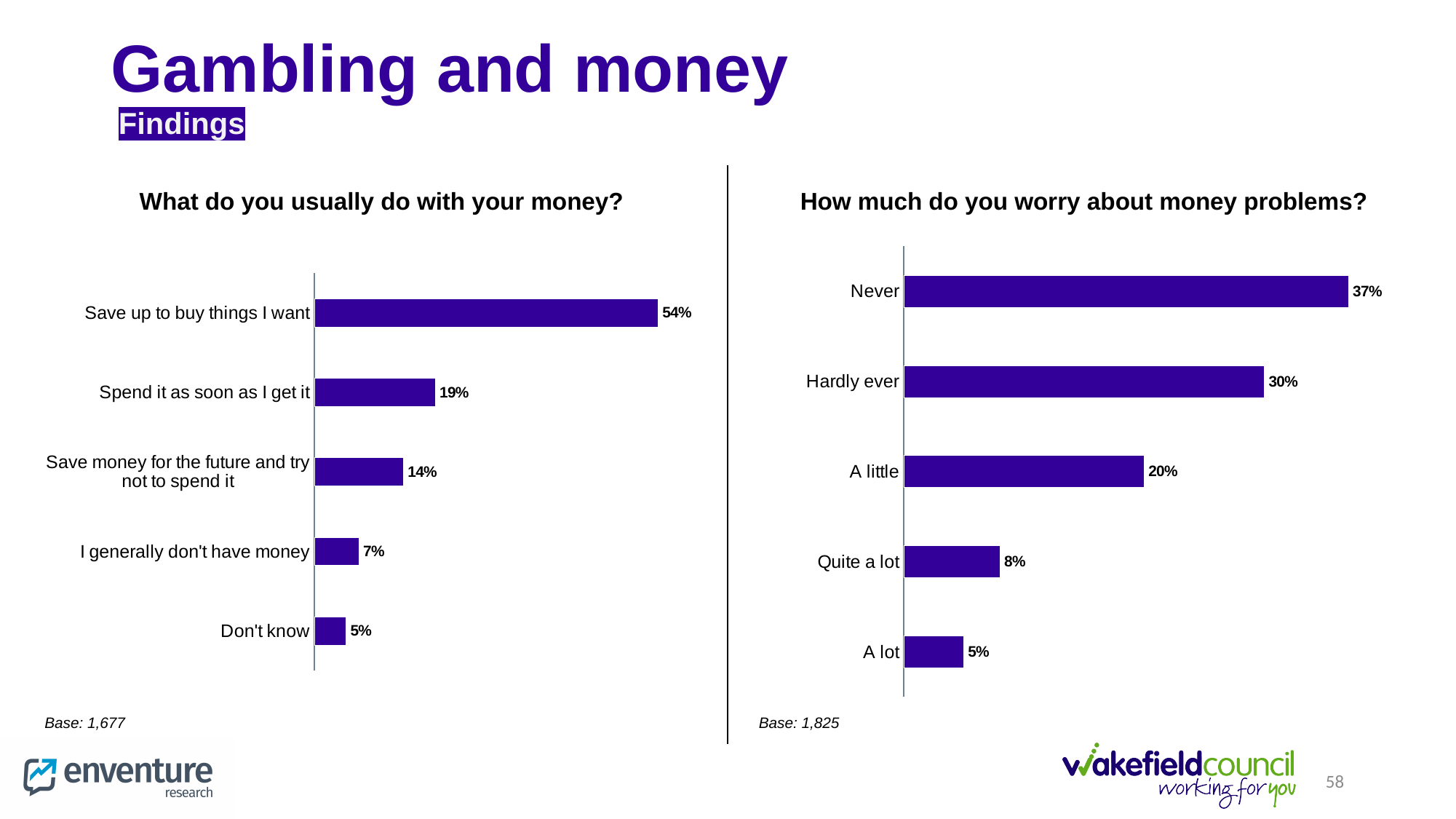
In the chart 'How much do you worry about money problems?', which is larger: 'A little' or 'Quite a lot'? A little What is the base (number of respondents) shown for the chart 'What do you usually do with your money?'? 1,677 In the chart 'How much do you worry about money problems?', what is the difference between 'Never' and 'Hardly ever'? 7 percentage points What type of chart is used on the right side of the slide, 'How much do you worry about money problems?'? Bar chart In the chart 'What do you usually do with your money?', what is the difference between 'Save up to buy things I want' and 'Spend it as soon as I get it'? 35 percentage points In the chart 'How much do you worry about money problems?', which category has the highest value? Never In the chart 'How much do you worry about money problems?', what percentage answered 'Hardly ever'? 30% In the chart 'What do you usually do with your money?', how many categories are shown? 5 In the chart 'What do you usually do with your money?', which category has the lowest value? Don't know In the chart 'How much do you worry about money problems?', what percentage answered 'A lot'? 5% In the chart 'What do you usually do with your money?', what percentage chose 'Save up to buy things I want'? 54% In the chart 'What do you usually do with your money?', what percentage chose 'Spend it as soon as I get it'? 19%